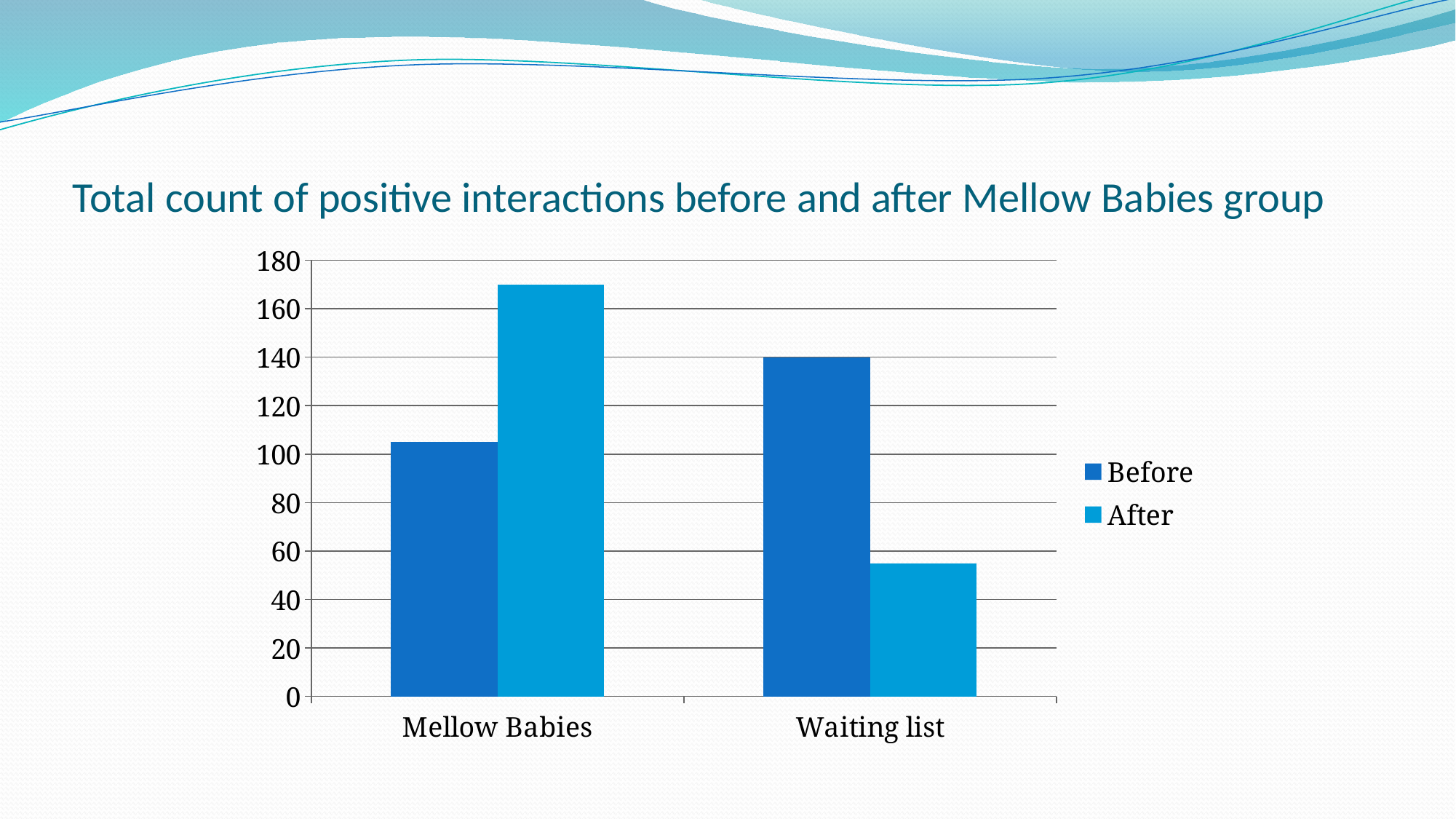
What is the Before value for Waiting list? 140 How many categories are shown on the x axis? 2 Is the After value for Waiting list greater or less than 80? less For Waiting list, which is larger: the Before value or the After value? Before For Mellow Babies, which is larger: the Before value or the After value? After What is the title of the chart? Total count of positive interactions before and after Mellow Babies group Is the After value for Mellow Babies greater or less than 160? greater Which bar is the lowest in the chart? Waiting list, After Which bar is the highest in the chart? Mellow Babies, After How many series does the legend list? 2 Is the Before value for Mellow Babies greater or less than 120? less What kind of chart is shown on the slide? bar chart